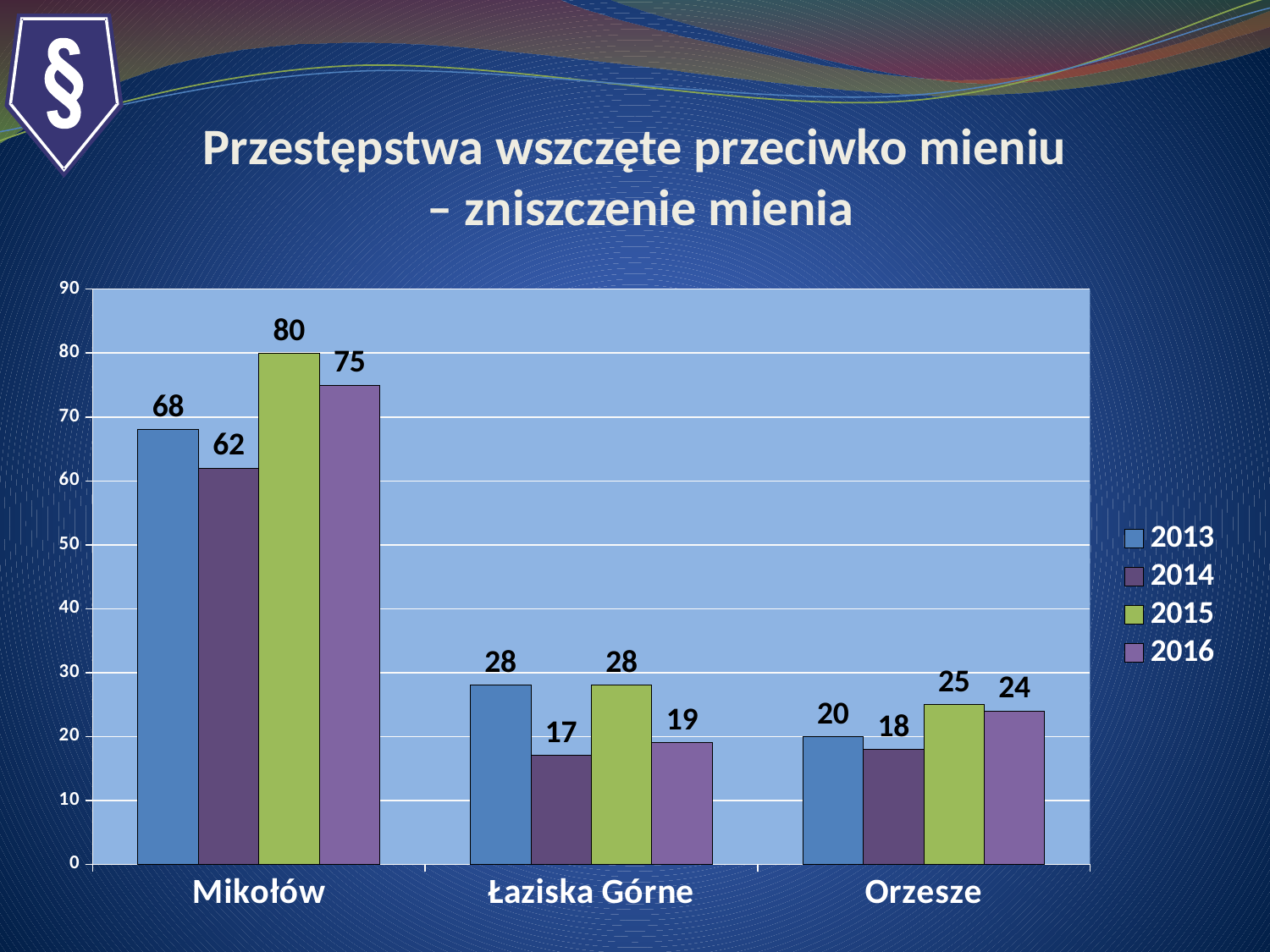
Which is larger: the 2013 value for Łaziska Górne or the 2013 value for Orzesze? Łaziska Górne How many categories are shown on the x axis? 3 Is the 2016 value for Mikołów greater or less than 70? greater Which year has the lowest value for Orzesze? 2014 What is the value for Orzesze in 2016? 24 What kind of chart is shown on the slide? bar chart Which year has the highest value for Mikołów? 2015 How many series does the legend list? 4 What is the difference between the 2015 and 2014 values for Mikołów? 18 What is the value for Mikołów in 2015? 80 What is the value for Łaziska Górne in 2014? 17 Which colour represents the 2015 series in the legend? green